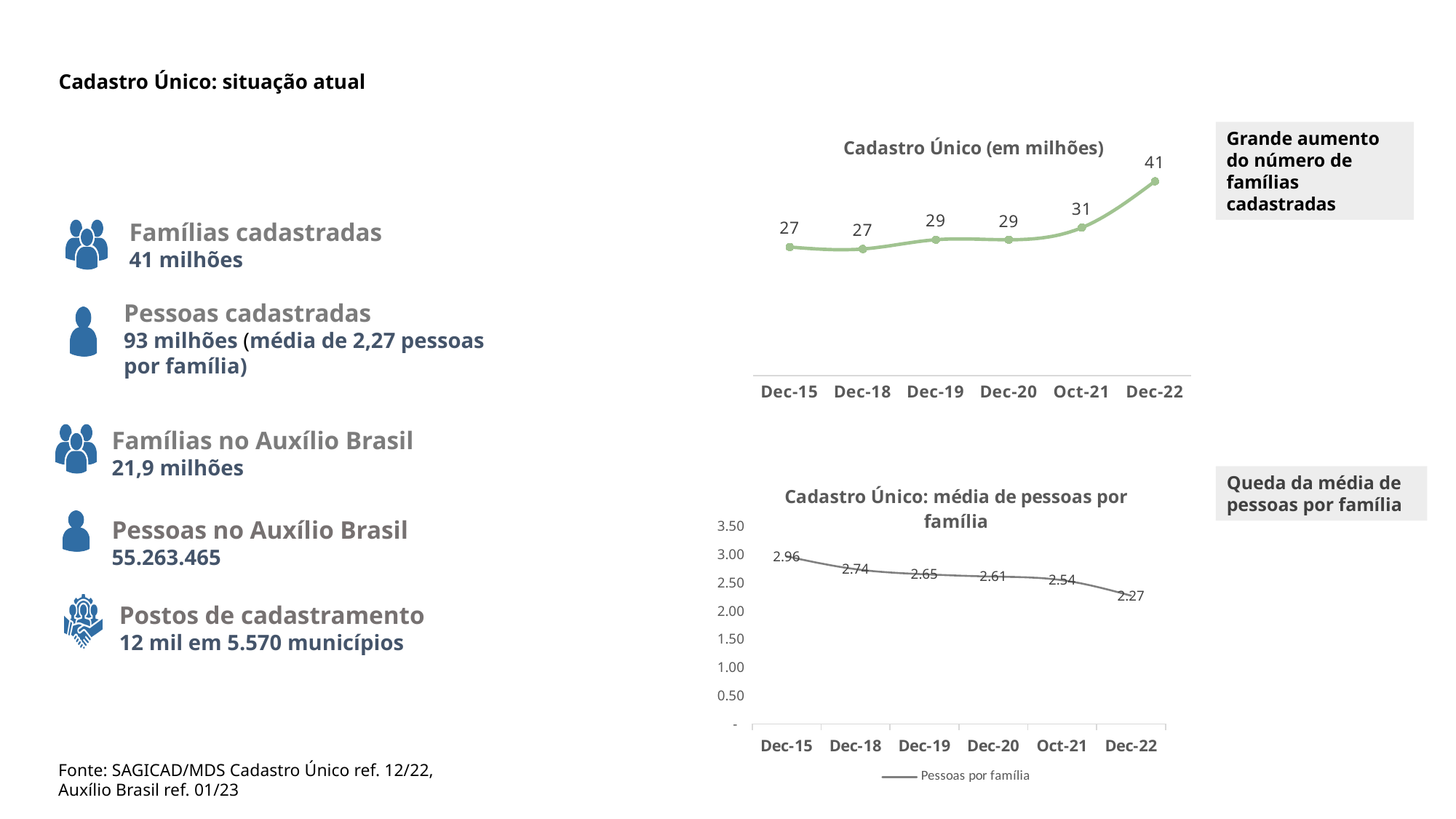
In the 'Cadastro Único (em milhões)' chart, what is the difference between the Dec-22 and Dec-15 values? 14 In the 'Cadastro Único (em milhões)' chart, what is the value for Oct-21? 31 What type of chart is the 'Cadastro Único: média de pessoas por família' chart? line chart In the 'Cadastro Único: média de pessoas por família' chart, is the value for Dec-19 larger or smaller than the value for Oct-21? larger In the 'Cadastro Único: média de pessoas por família' chart, which period has the highest value? Dec-15 In the 'Cadastro Único (em milhões)' chart, do the values rise or fall from Dec-15 to Dec-22? rise In the 'Cadastro Único: média de pessoas por família' chart, what is the value for Dec-15? 2.96 In the 'Cadastro Único (em milhões)' chart, which period has the lowest value? Dec-15 and Dec-18 (both 27) In the 'Cadastro Único (em milhões)' chart, what is the value for Dec-22? 41 In the 'Cadastro Único: média de pessoas por família' chart, what series does the legend list? Pessoas por família In the 'Cadastro Único: média de pessoas por família' chart, what is the value for Dec-22? 2.27 In the 'Cadastro Único (em milhões)' chart, how many data points are plotted? 6